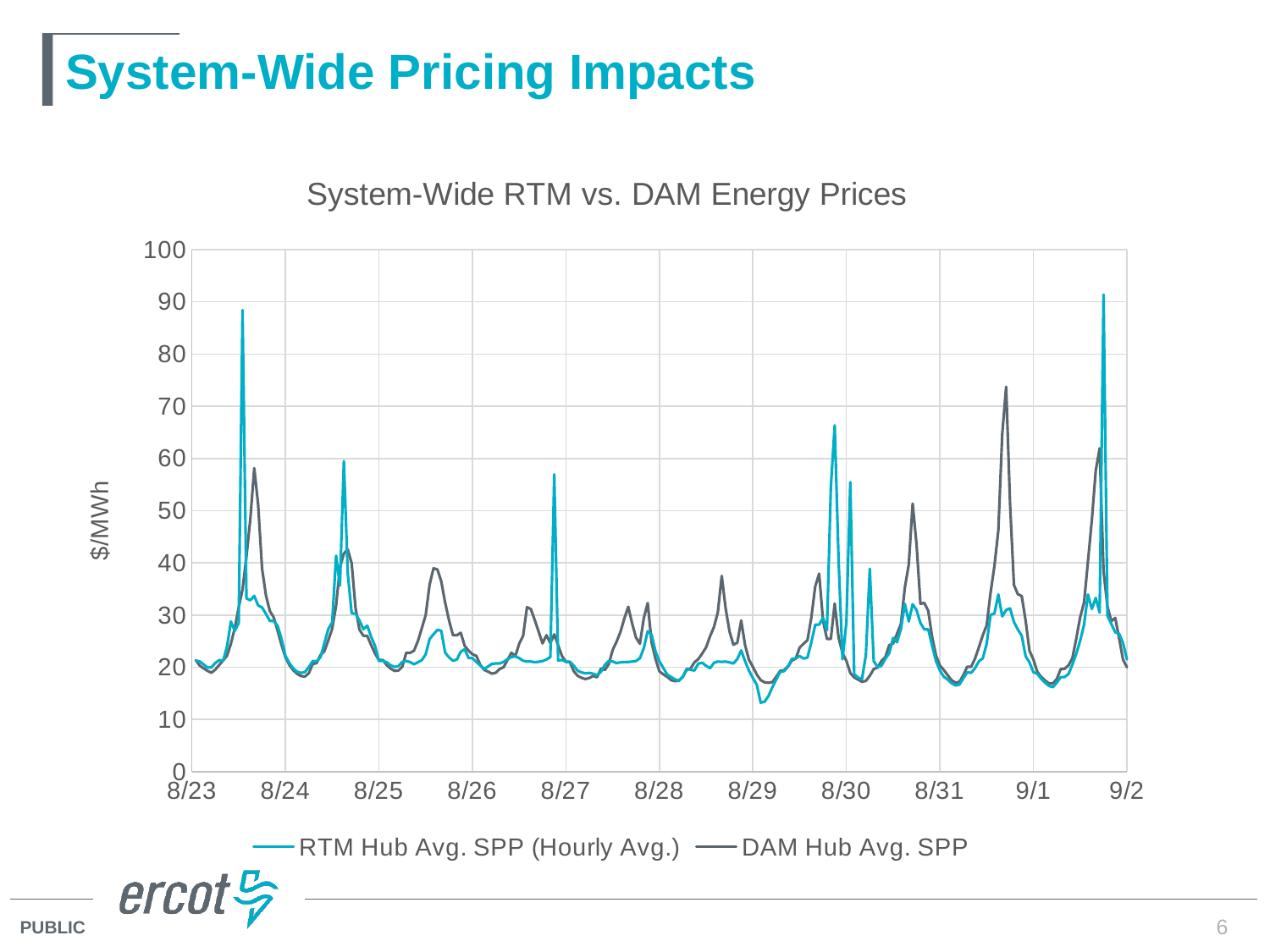
Is the lowest RTM Hub Avg. SPP (Hourly Avg.) value, near 8/29, greater or less than 20 $/MWh? less How many date labels are shown along the x axis? 11 Which series reaches the higher maximum value over the whole period, RTM Hub Avg. SPP (Hourly Avg.) or DAM Hub Avg. SPP? RTM Hub Avg. SPP (Hourly Avg.) What is the label on the vertical axis? $/MWh Is the DAM Hub Avg. SPP peak between 8/25 and 8/26 greater or less than 30 $/MWh? greater What kind of chart is shown on the slide? line chart Is the DAM Hub Avg. SPP peak between 8/31 and 9/1 greater or less than 70 $/MWh? greater What is the title of the chart? System-Wide RTM vs. DAM Energy Prices At the peak between 8/31 and 9/1, which series is higher, RTM Hub Avg. SPP (Hourly Avg.) or DAM Hub Avg. SPP? DAM Hub Avg. SPP How many series does the legend list? 2